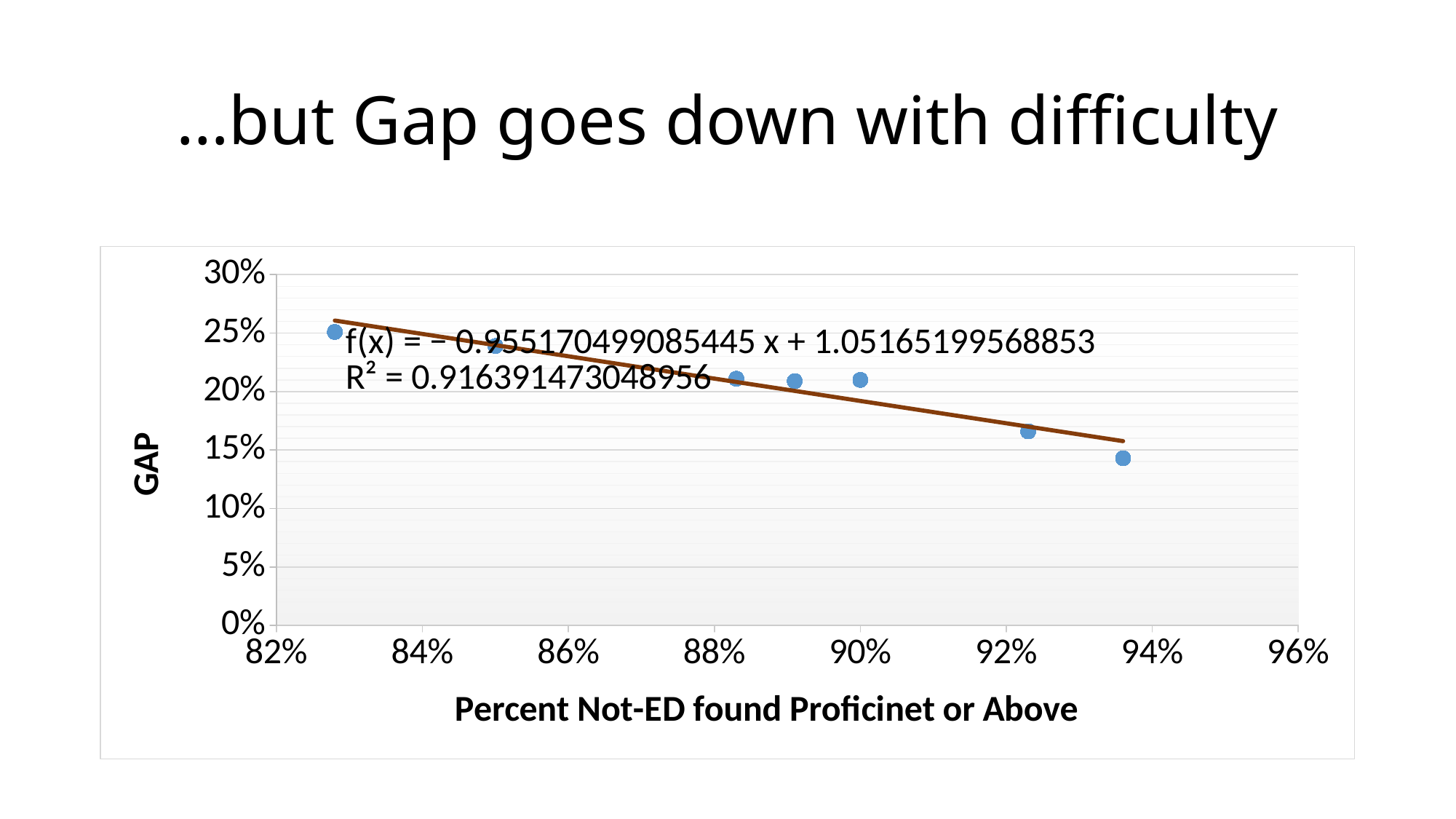
What is the title of the slide? ...but Gap goes down with difficulty Which has the larger GAP: the data point near 88% or the data point near 92% on the x axis? the data point near 88% Is the GAP value for the leftmost data point (near 83% on the x axis) greater or less than 20%? greater What is the R² value printed on the chart? R² = 0.916391473048956 How many data points are plotted in the chart? 7 Is the GAP value for the rightmost data point (near 94% on the x axis) greater or less than 15%? less What kind of chart is shown on the slide? scatter chart Is the GAP value for the data point near 90% on the x axis greater or less than 20%? greater Which data point has the highest GAP: the leftmost point or the rightmost point? the leftmost point As the percent of Not-ED found proficient or above increases along the x axis, does the GAP rise or fall? fall Which data point has the lowest GAP: the point near 92% or the point near 94% on the x axis? the point near 94%